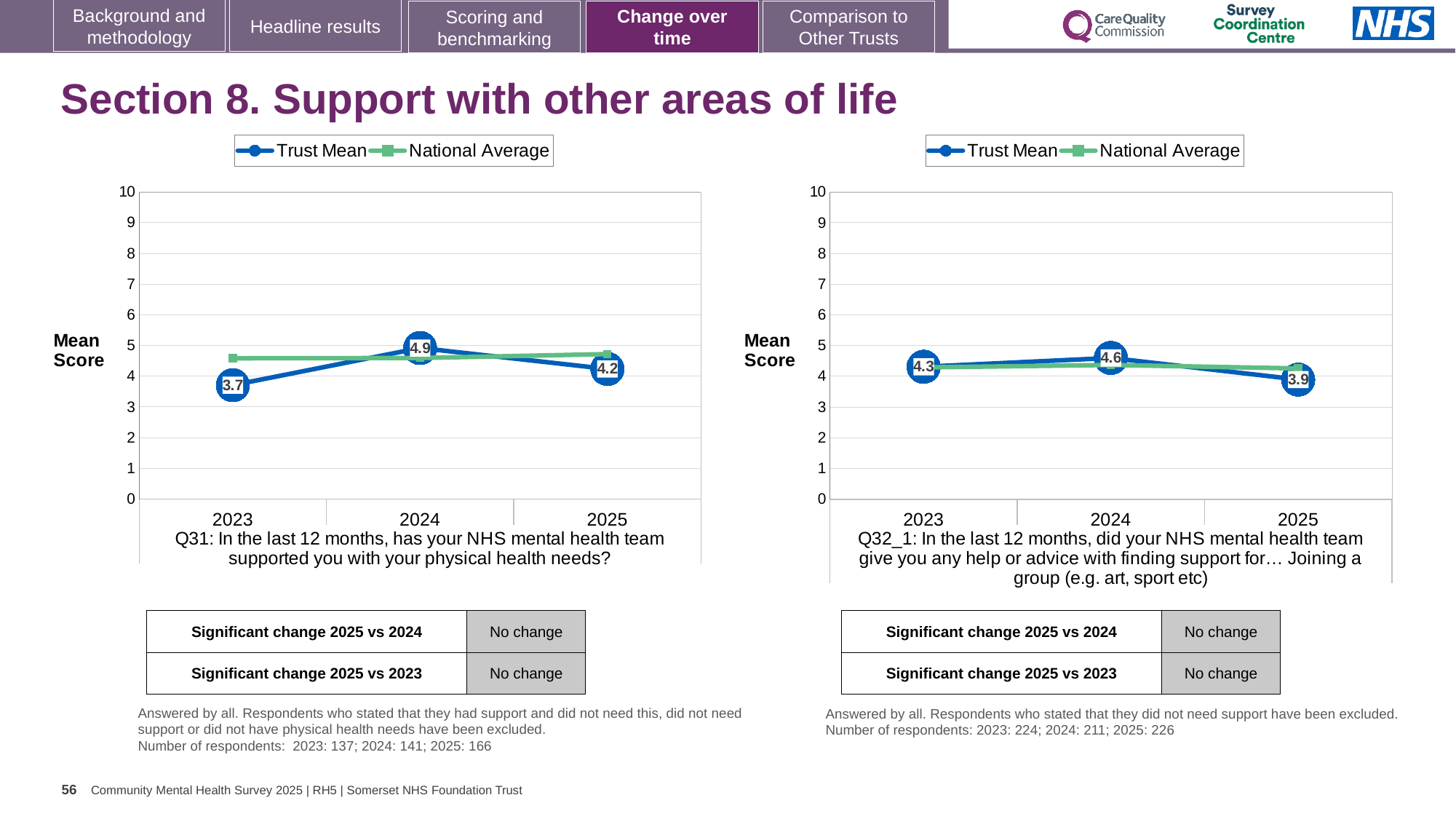
On the left chart (Q31), what is the Trust Mean for 2023? 3.7 On the right chart (Q32_1), which year has the highest Trust Mean? 2024 What kind of chart is the left chart (Q31)? Line chart On the left chart (Q31), what is the difference between the Trust Mean for 2024 and 2023? 1.2 On the left chart (Q31), is the National Average for 2023 greater or less than 4? greater On the right chart (Q32_1), what is the difference between the Trust Mean for 2024 and 2025? 0.7 On the right chart (Q32_1), does the Trust Mean rise or fall from 2024 to 2025? Fall On the left chart (Q31), which year has the lowest Trust Mean? 2023 On the left chart (Q31), what is the Trust Mean for 2024? 4.9 How many series does the legend of the right chart (Q32_1) list? 2 On the left chart (Q31), is the Trust Mean higher in 2025 or in 2023? 2025 On the right chart (Q32_1), what is the Trust Mean for 2025? 3.9